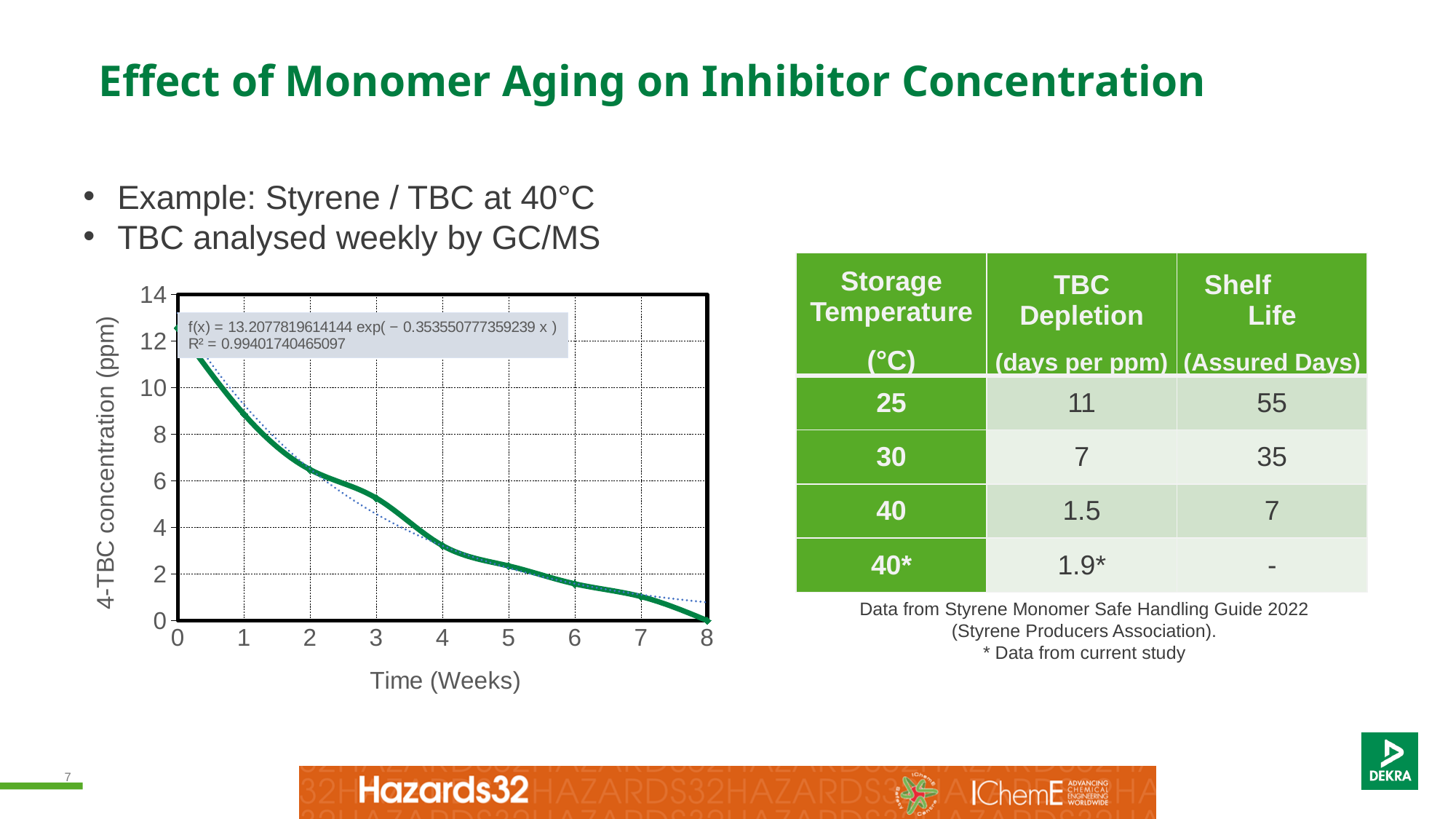
Is the 4-TBC concentration at week 2 greater or less than 8? less Is the 4-TBC concentration higher at week 2 or at week 5? week 2 Is the 4-TBC concentration at week 1 greater or less than 8? greater Which week has the highest 4-TBC concentration on the chart? 0 Which week has the lowest 4-TBC concentration on the chart? 8 Is the 4-TBC concentration at week 6 greater or less than 2? less What is the title of the x axis of the chart? Time (Weeks) What R² value is printed on the chart for the fitted trendline? 0.99401740465097 Does the 4-TBC concentration rise or fall as time increases along the x axis? fall What kind of chart is shown on the slide? line chart